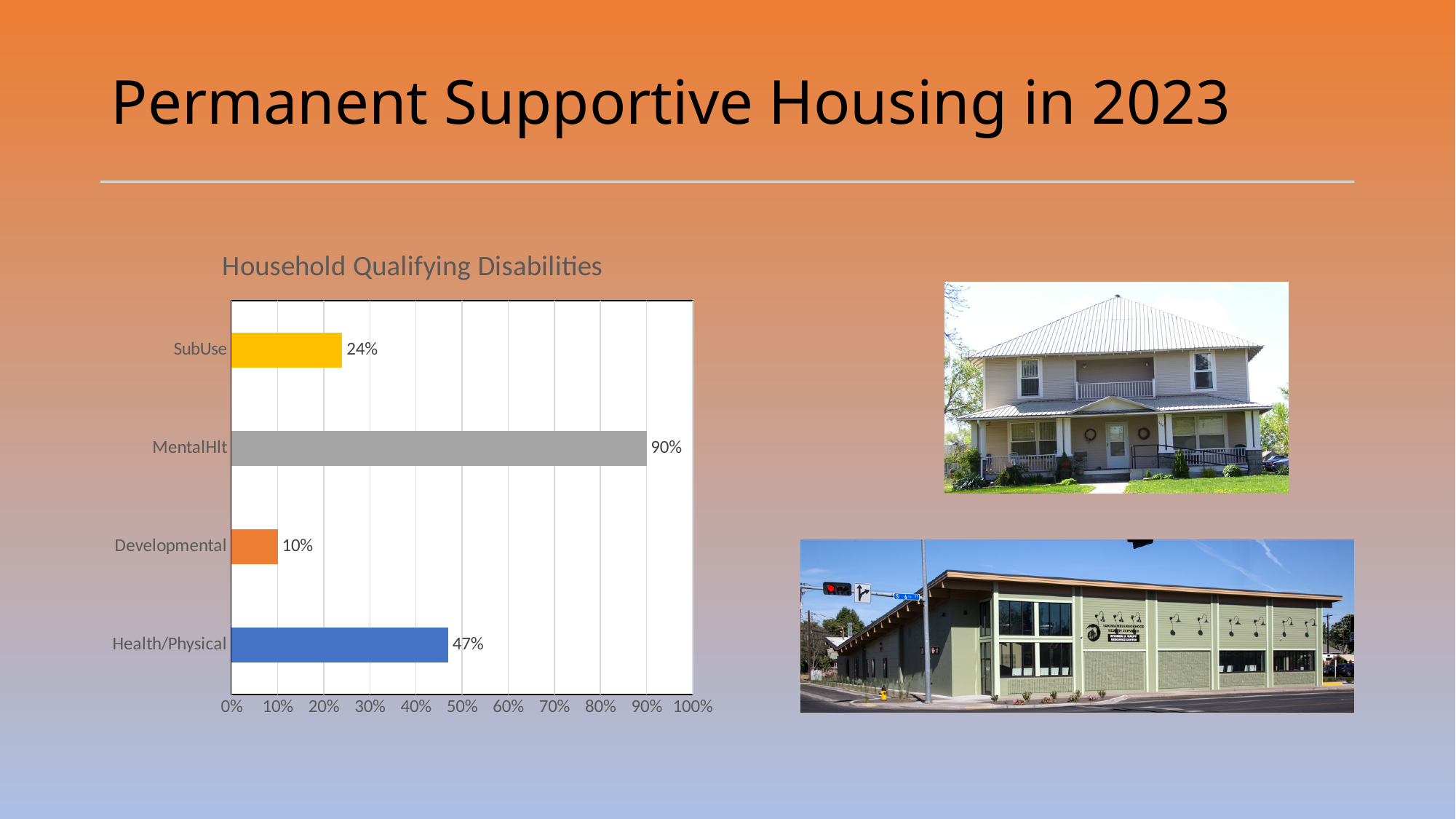
What is the difference between the SubUse and Developmental values in the Household Qualifying Disabilities chart? 14% What is the difference between the MentalHlt and Health/Physical values in the Household Qualifying Disabilities chart? 43% What is the value for SubUse in the Household Qualifying Disabilities chart? 24% Which category has the lowest value in the Household Qualifying Disabilities chart? Developmental What is the value for MentalHlt in the Household Qualifying Disabilities chart? 90% What is the value for Developmental in the Household Qualifying Disabilities chart? 10% What kind of chart is the Household Qualifying Disabilities chart? Bar chart How many categories are shown in the Household Qualifying Disabilities chart? 4 What is the value for Health/Physical in the Household Qualifying Disabilities chart? 47% Which is larger in the Household Qualifying Disabilities chart, SubUse or Health/Physical? Health/Physical What is the title of the chart on the slide? Household Qualifying Disabilities Which category has the highest value in the Household Qualifying Disabilities chart? MentalHlt